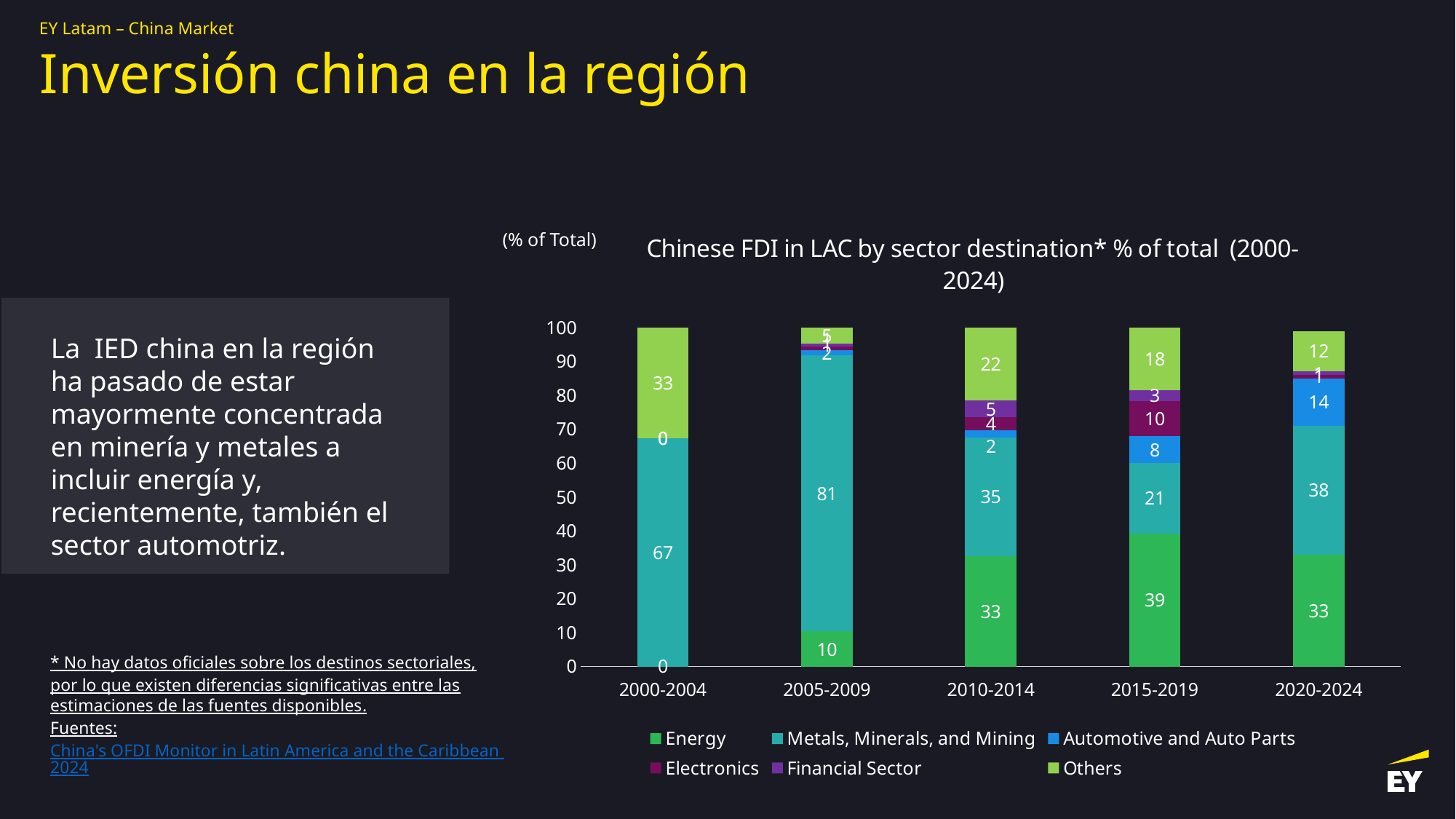
What is the value for Others in 2010-2014? 22 What is the title of the chart? Chinese FDI in LAC by sector destination* % of total (2000-2024) What is the value for Metals, Minerals, and Mining in 2000-2004? 67 What type of chart is shown on the slide? Stacked bar chart What is the difference between the Metals, Minerals, and Mining value in 2005-2009 and in 2015-2019? 60 Which is larger in 2020-2024: Energy or Metals, Minerals, and Mining? Metals, Minerals, and Mining What is the value for Energy in 2015-2019? 39 How many time periods are shown on the x axis? 5 How many series does the legend list? 6 What is the value for Automotive and Auto Parts in 2020-2024? 14 In which period is the Metals, Minerals, and Mining share highest? 2005-2009 In which period is the Energy share lowest? 2000-2004